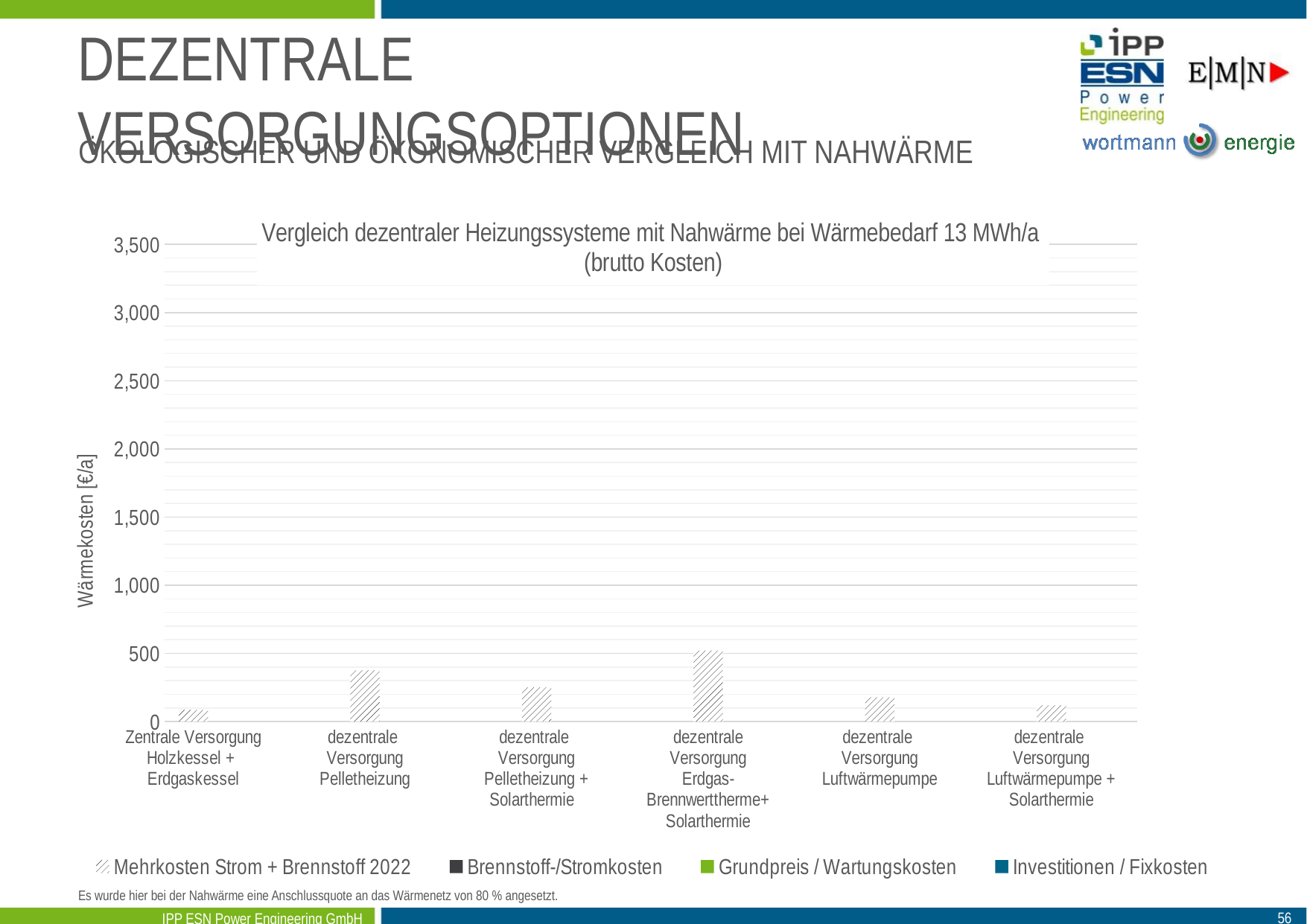
Which category has the lowest visible bar? Zentrale Versorgung Holzkessel + Erdgaskessel How many series does the legend list? 4 Is the value for dezentrale Versorgung Luftwärmepumpe greater or less than 500? less Which is larger: the bar for dezentrale Versorgung Erdgas-Brennwerttherme+Solarthermie or for dezentrale Versorgung Luftwärmepumpe? dezentrale Versorgung Erdgas-Brennwerttherme+Solarthermie What is the label of the y axis? Wärmekosten [€/a] Is the value for dezentrale Versorgung Pelletheizung + Solarthermie greater or less than 1,000? less What kind of chart is shown on the slide? bar chart Is the value for dezentrale Versorgung Pelletheizung greater or less than 500? less Which is larger: the bar for dezentrale Versorgung Pelletheizung or for dezentrale Versorgung Pelletheizung + Solarthermie? dezentrale Versorgung Pelletheizung Which category has the highest visible bar? dezentrale Versorgung Erdgas-Brennwerttherme+Solarthermie Which legend entry is shown with a hatched pattern? Mehrkosten Strom + Brennstoff 2022 How many heating system categories are shown along the x axis? 6